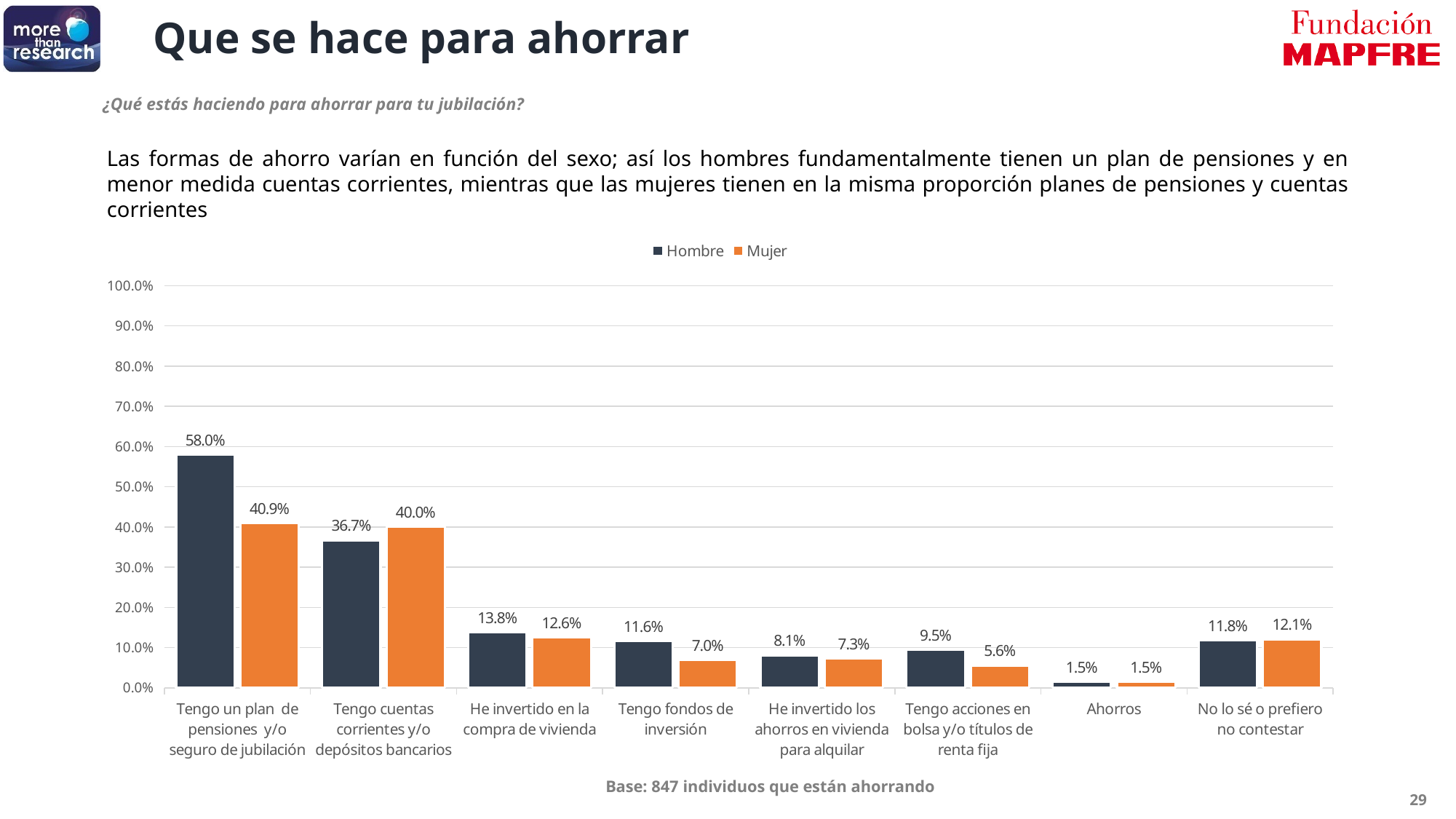
Which category has the highest Hombre value? Tengo un plan de pensiones y/o seguro de jubilación What is the Mujer value for "Tengo cuentas corrientes y/o depósitos bancarios"? 40.0% Which colour represents the Mujer series? Orange What kind of chart is shown on the slide? Bar chart What is the Mujer value for "Tengo fondos de inversión"? 7.0% Which category has the lowest Mujer value? Ahorros What is the difference between the Hombre and Mujer values for "Tengo un plan de pensiones y/o seguro de jubilación"? 17.1% Which is larger for "Tengo cuentas corrientes y/o depósitos bancarios": the Hombre value or the Mujer value? Mujer How many series does the legend list? 2 Is the Hombre value for "Tengo un plan de pensiones y/o seguro de jubilación" greater or less than 50.0%? greater How many categories are shown on the x axis? 8 What is the Hombre value for "Tengo un plan de pensiones y/o seguro de jubilación"? 58.0%